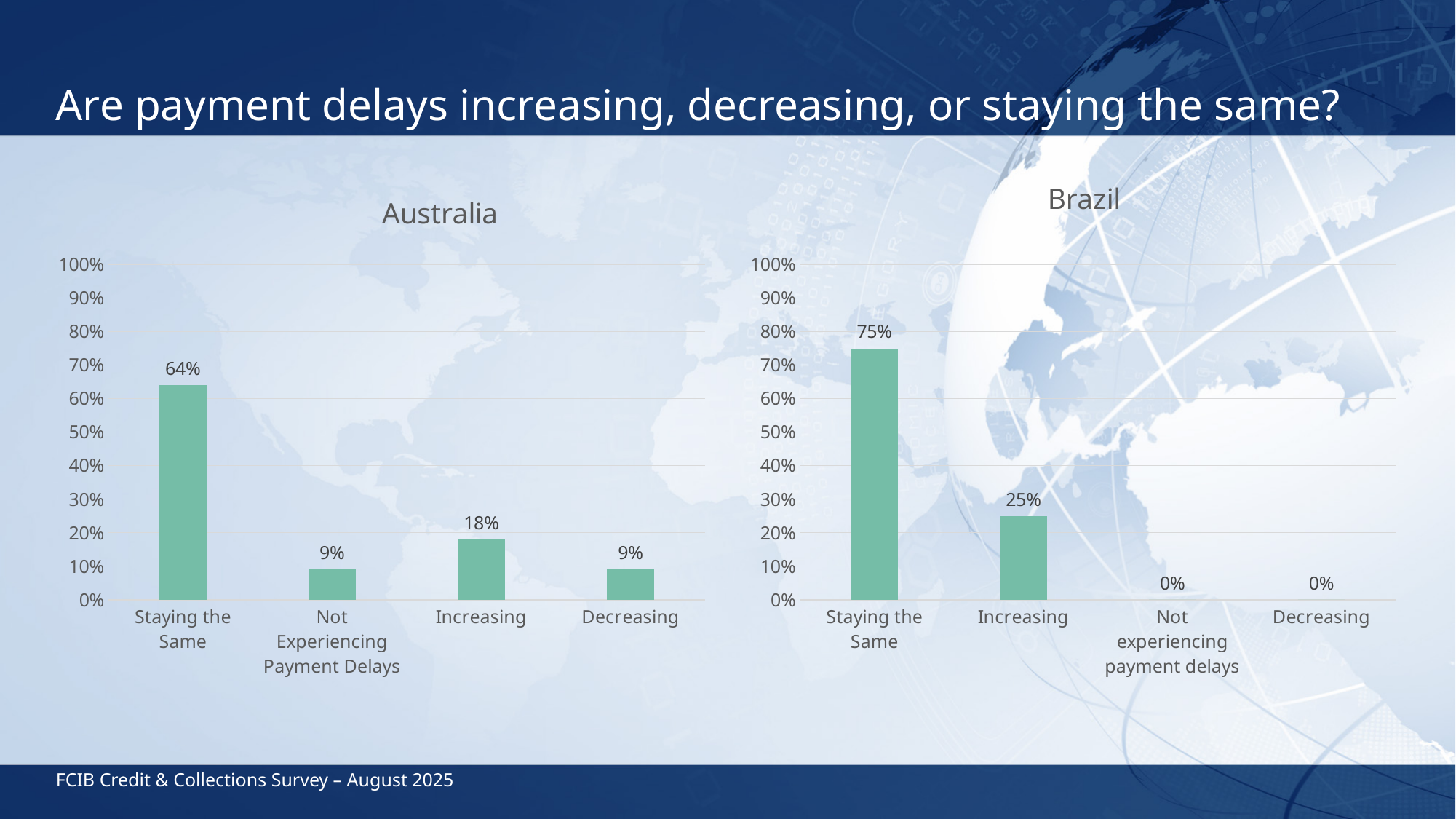
How many categories does the Australia chart show? 4 In the Brazil chart, which category has the highest value? Staying the Same In the Brazil chart, what is the difference between Staying the Same and Increasing? 50% In the Brazil chart, what is the value for Staying the Same? 75% What type of chart is the Brazil chart? Bar chart In the Australia chart, what is the difference between Staying the Same and Increasing? 46% In the Australia chart, which category has the highest value? Staying the Same In the Brazil chart, what is the value for Increasing? 25% In the Australia chart, what is the value for Increasing? 18% Which is larger: Increasing in the Australia chart or Increasing in the Brazil chart? Brazil In the Australia chart, what is the value for Staying the Same? 64% In the Brazil chart, what is the value for Decreasing? 0%